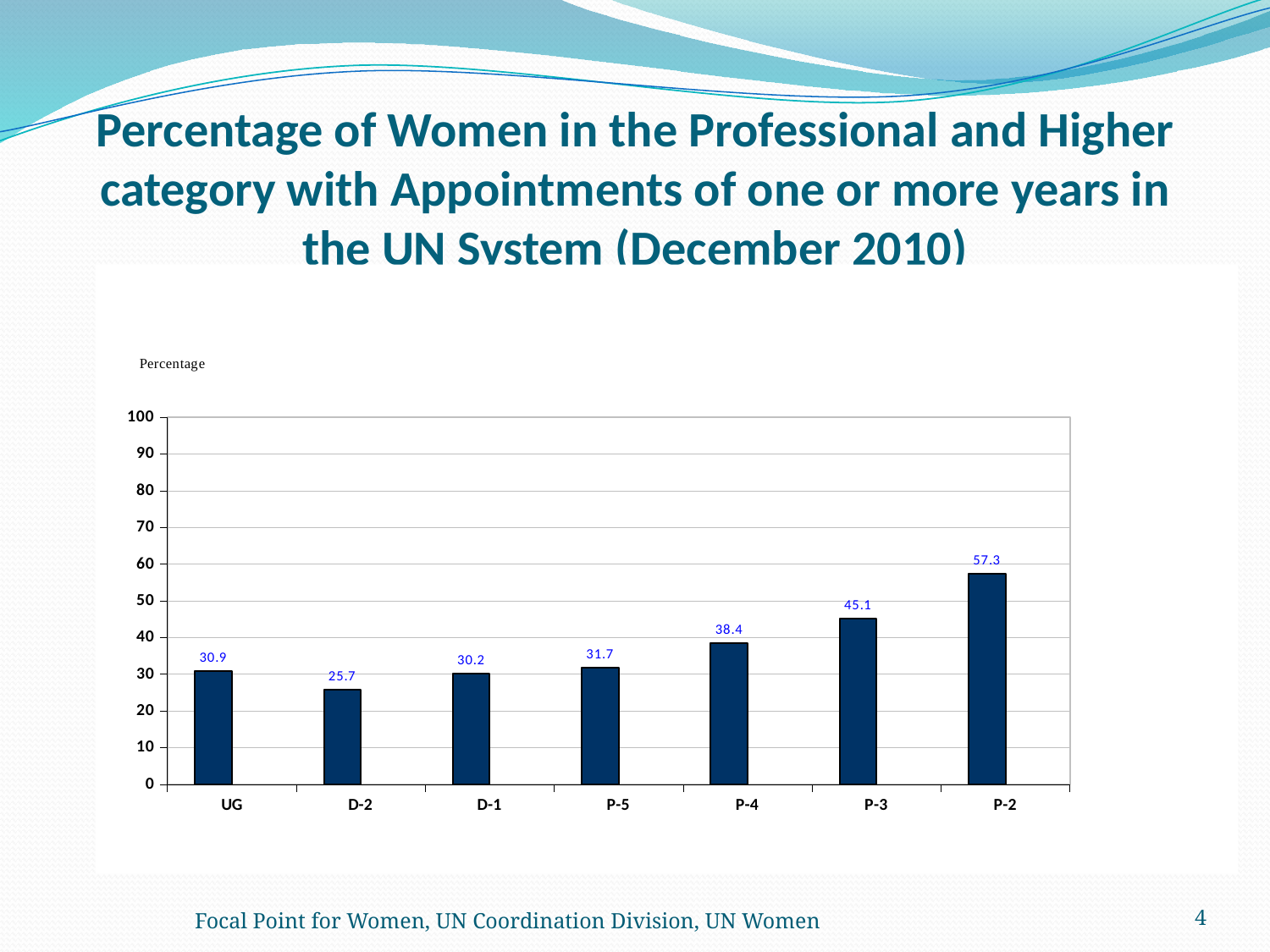
Do the values generally rise or fall from P-5 to P-2 along the x axis? Rise What is the difference between the percentage of women at P-2 and at P-3? 12.2 How many levels are shown on the x axis? 7 Which level has the highest percentage of women? P-2 What is the label on the vertical axis of the chart? Percentage What is the percentage of women at the P-2 level? 57.3 Which level has the lowest percentage of women? D-2 What is the percentage of women at the D-2 level? 25.7 What is the percentage of women at the UG level? 30.9 What kind of chart is shown on the slide? Bar chart Is the value for P-3 greater or less than 40? greater Which level has a higher percentage of women, P-4 or P-5? P-4